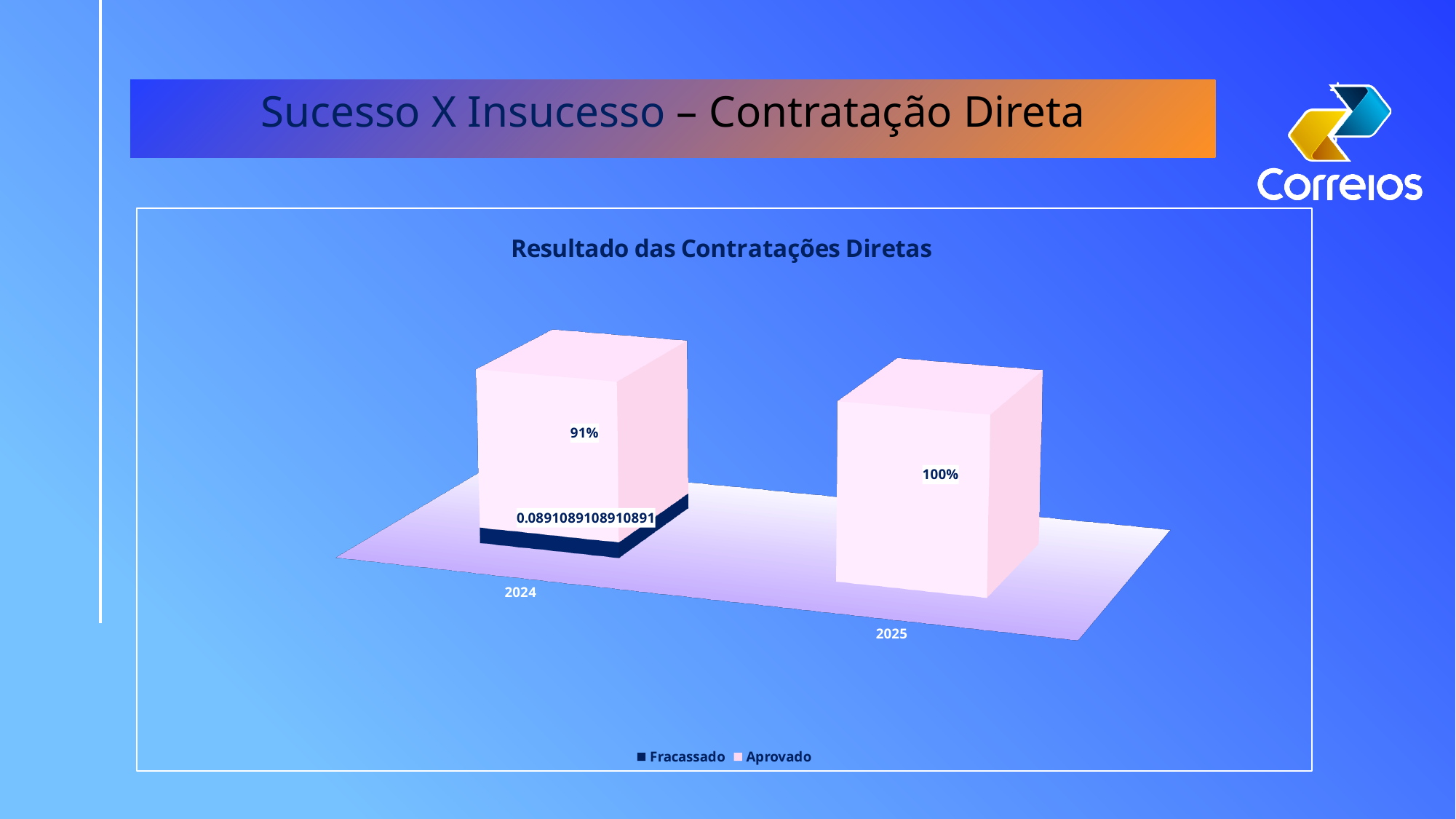
What is the Aprovado value for 2025? 100% Which year has the higher Aprovado value? 2025 Which series are listed in the chart legend? Fracassado and Aprovado What is the title of the chart? Resultado das Contratações Diretas Is the Aprovado value for 2024 larger or smaller than the Aprovado value for 2025? Smaller Does the Aprovado value rise or fall from 2024 to 2025? Rise How many categories are shown on the x axis of the chart? 2 What is the Aprovado value for 2024? 91% Which year has the lower Aprovado value? 2024 What is the Fracassado value labelled for 2024? 0.0891089108910891 What kind of chart is shown on the slide? Stacked bar chart How many series does the chart legend list? 2